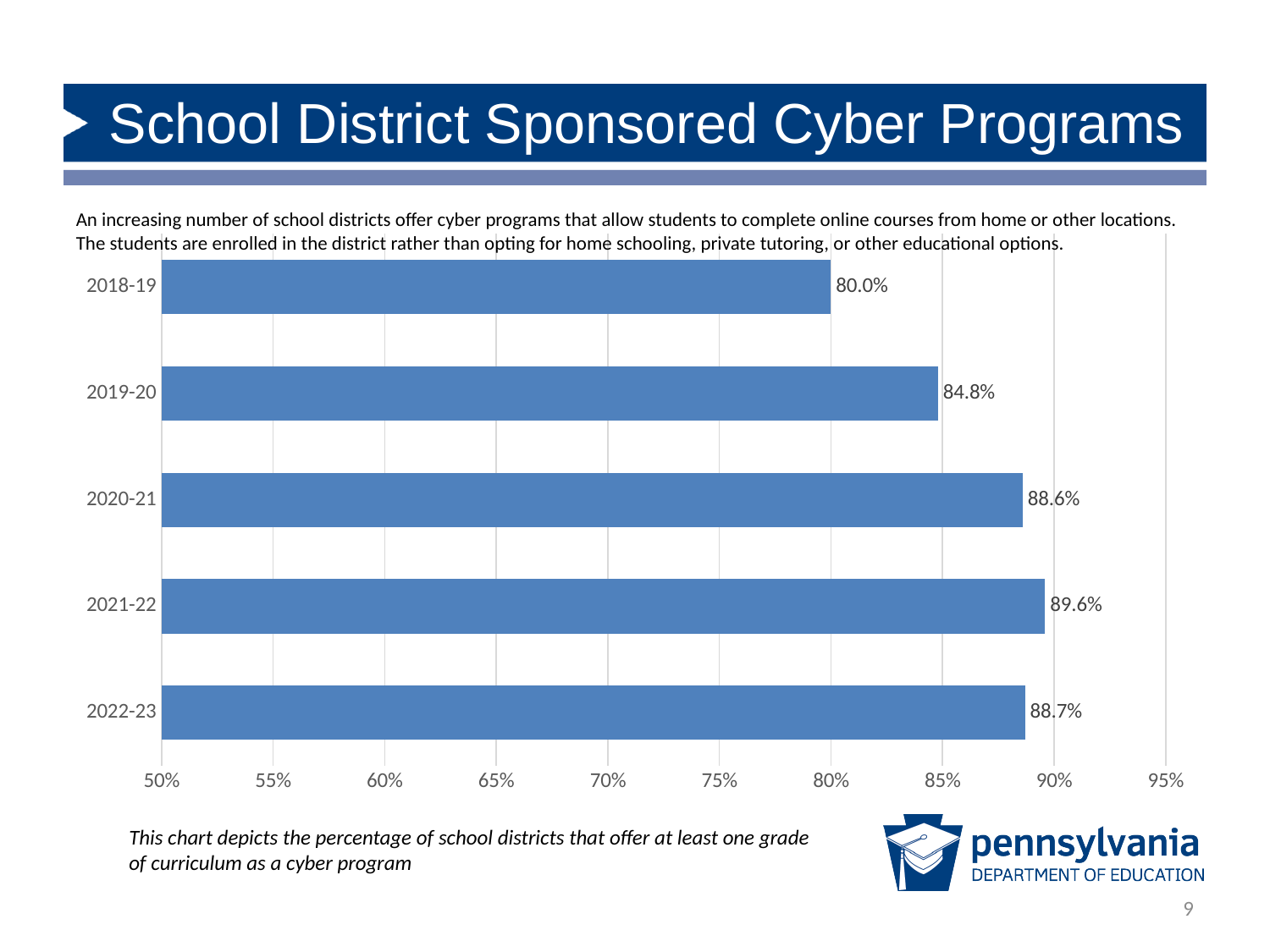
What is the value for 2020-21? 88.6% What is the difference between the values for 2021-22 and 2022-23? 0.9% What is the difference between the values for 2019-20 and 2018-19? 4.8% What is the value for 2018-19? 80.0% Which school year has the lowest value? 2018-19 Which is larger, the value for 2019-20 or the value for 2020-21? 2020-21 What is the title of the slide containing the chart? School District Sponsored Cyber Programs How many school years are shown in the chart? 5 Which school year has the highest value? 2021-22 What is the value for 2022-23? 88.7% Is the value for 2019-20 greater or less than 85%? less What kind of chart is shown on the slide? bar chart